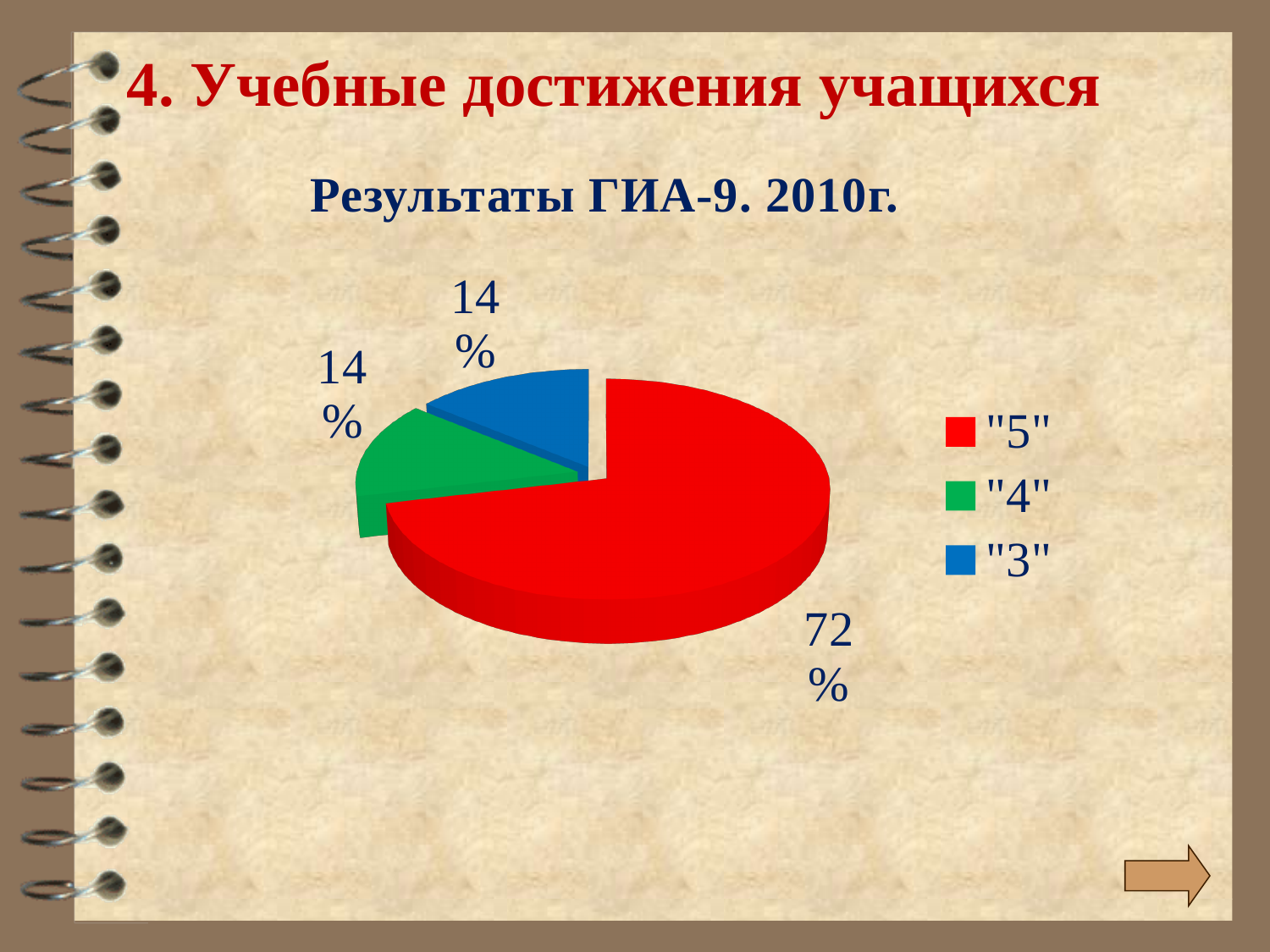
What share of the pie does the "5" slice take? 72% What kind of chart is shown on the slide? pie chart How many entries does the legend list? 3 Which is larger, the slice for "5" or the slice for "4"? "5" Which category has the largest slice of the pie? "5" What is the value shown for the "4" slice? 14% What is the value shown for the "3" slice? 14% How many slices does the pie chart have? 3 What is the title of the chart? Результаты ГИА-9. 2010г. What colour is the slice for "5"? red What is the difference between the share for "5" and the share for "3"? 58%